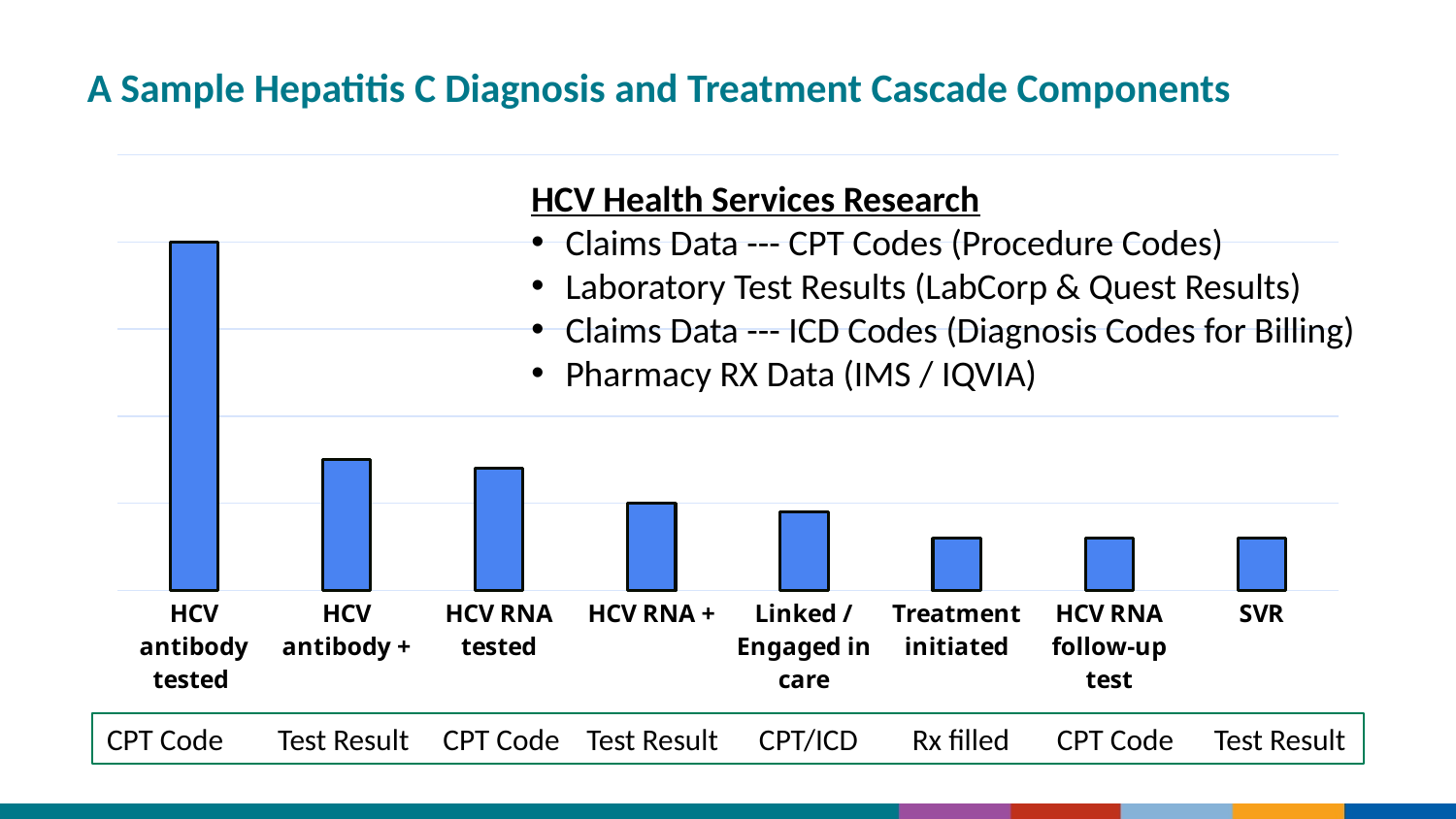
Which is larger, the bar for HCV antibody + or the bar for Treatment initiated? HCV antibody + What kind of chart is shown on the slide? bar chart Which is larger, the bar for HCV RNA tested or the bar for SVR? HCV RNA tested How many categories (bars) does the chart show? 8 Which is larger, the bar for HCV RNA + or the bar for HCV RNA follow-up test? HCV RNA + What is the label of the first (leftmost) category on the x axis? HCV antibody tested Which category has the highest bar? HCV antibody tested Do the bar heights generally rise or fall moving from left to right along the x axis? fall What is the label of the last (rightmost) category on the x axis? SVR